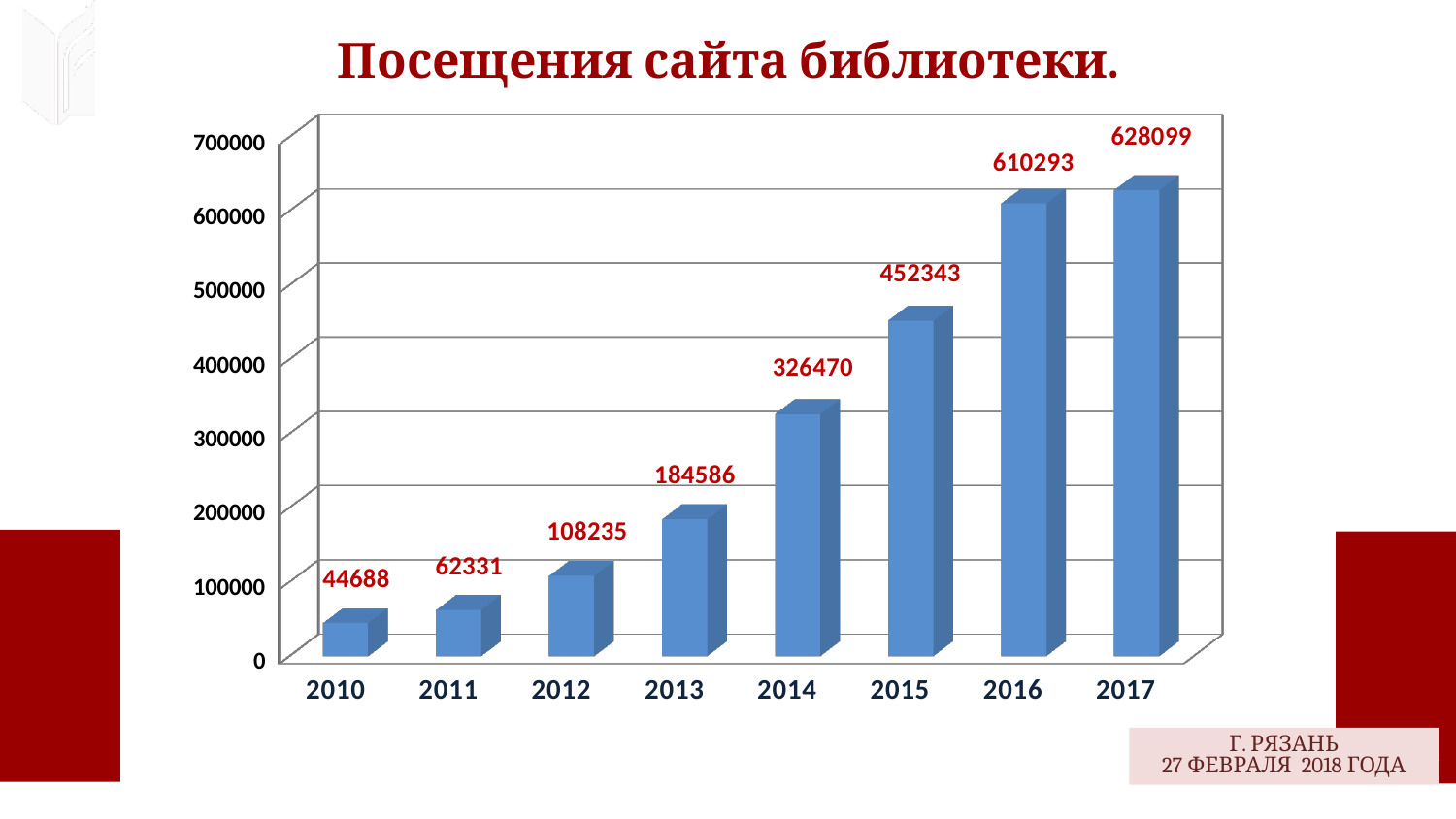
What kind of chart is shown on the slide? bar chart What is the value for 2010? 44688 Which year has the lowest value? 2010 Which year has the highest value? 2017 How many years are shown on the x axis? 8 What is the value for 2016? 610293 What is the difference between the values for 2017 and 2016? 17806 What is the value for 2014? 326470 Is the value for 2015 greater or less than 400000? greater Which is larger, the value for 2012 or the value for 2013? 2013 Do the values rise or fall from 2010 to 2017? rise What is the difference between the values for 2014 and 2013? 141884